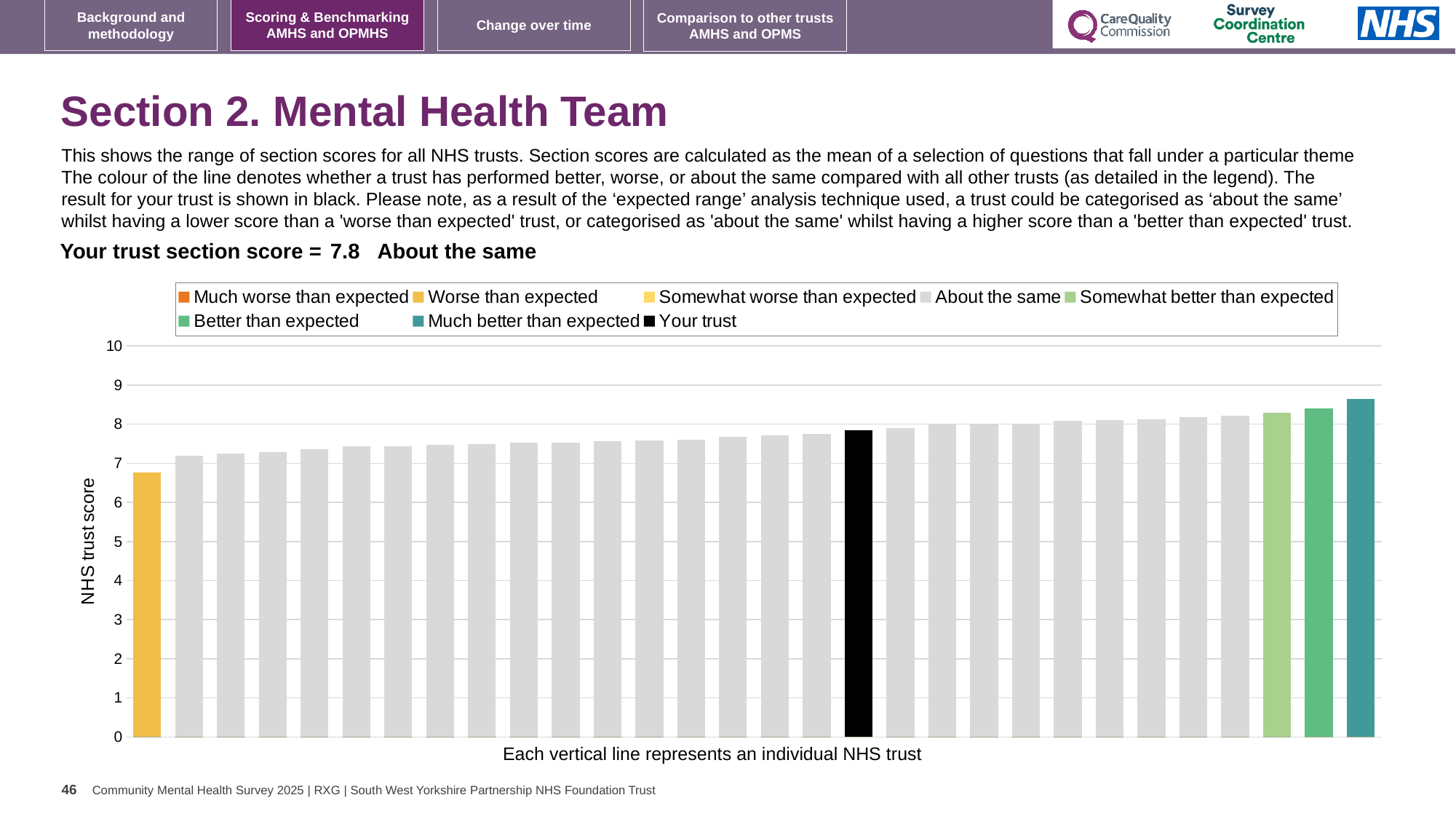
Is the value of the 'Worse than expected' (yellow) bar greater or less than 7? less What is the section score for your trust shown on the slide? 7.8 Is the value of the black 'Your trust' bar greater or less than 7? greater Is the value of the tallest bar greater or less than 8? greater Which legend category does the lowest bar in the chart belong to? Worse than expected What kind of chart is shown on the slide? Bar chart Which legend category does the highest bar in the chart belong to? Much better than expected Do the bar values rise or fall from left to right across the chart? rise Is the bar for your trust higher or lower than the 'Worse than expected' bar? higher How many entries does the chart legend list? 8 Which category is your trust placed in for this section? About the same How many bars are coloured as 'Much better than expected'? 1